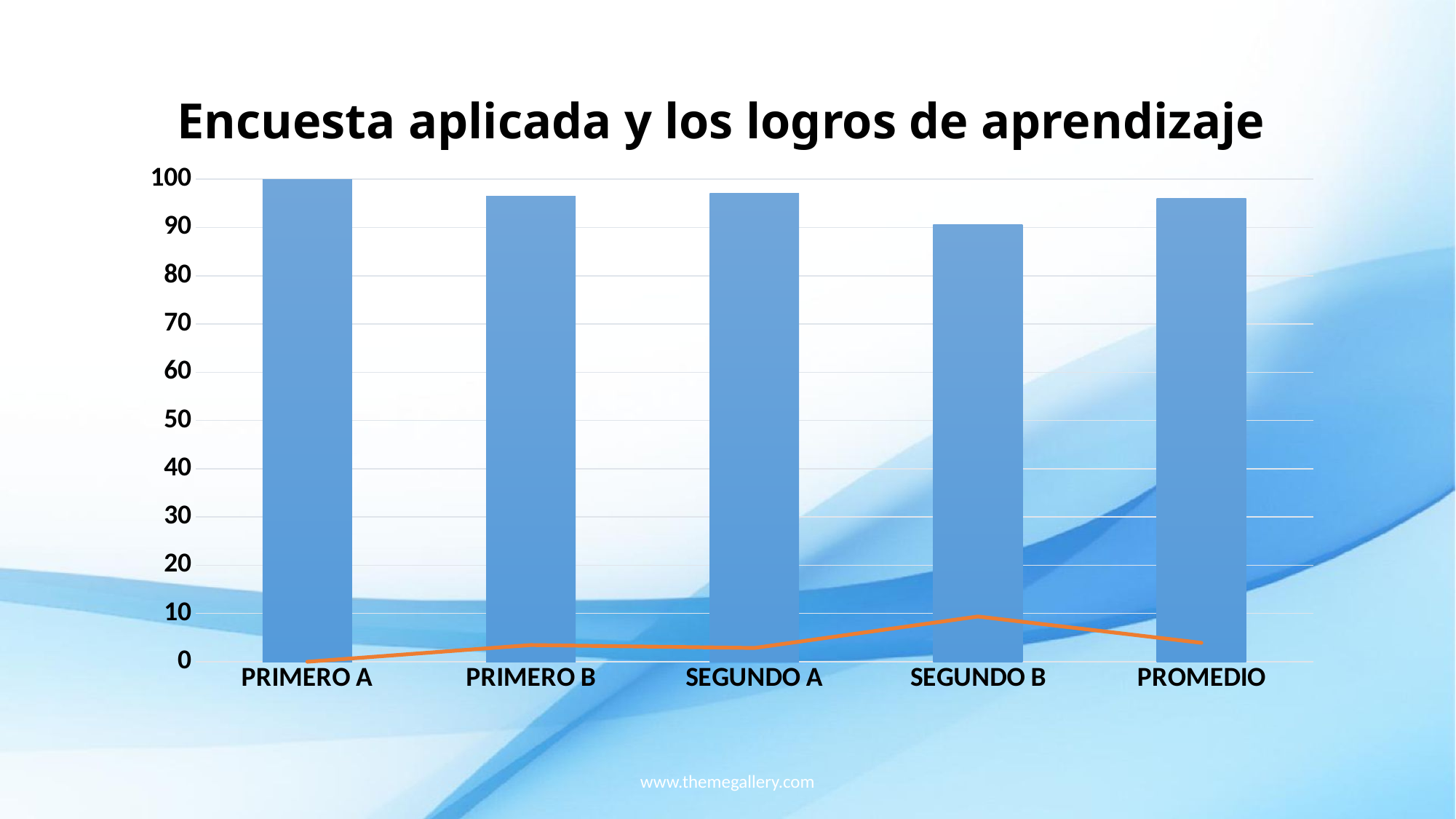
Which category has the tallest blue bar? PRIMERO A What is the title of the chart? Encuesta aplicada y los logros de aprendizaje How many categories are shown on the x axis? 5 What kind of chart is used for the blue series? bar chart What is the value of the blue bar for PRIMERO A? 100 Is the blue bar value for SEGUNDO B greater or less than 80? greater Which category has the shortest blue bar? SEGUNDO B Is the blue bar value for PRIMERO B greater or less than 90? greater Which blue bar is taller, PRIMERO A or SEGUNDO B? PRIMERO A Is the orange line value for SEGUNDO B greater or less than 20? less At which category does the orange line reach its highest point? SEGUNDO B Which blue bar is taller, SEGUNDO A or SEGUNDO B? SEGUNDO A